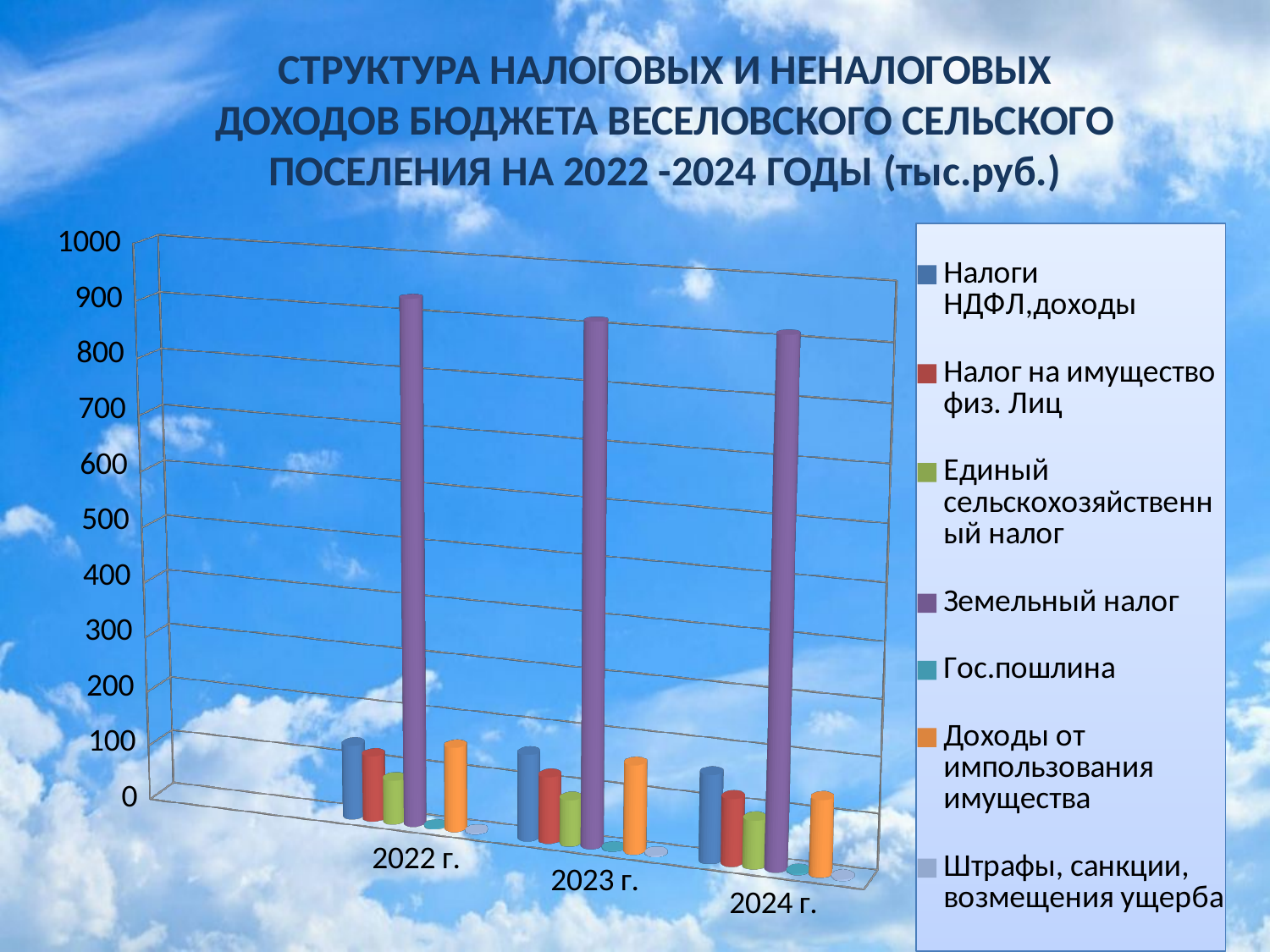
Which is larger: Земельный налог in 2022 or Земельный налог in 2024? Земельный налог in 2022 What unit of measurement is stated in the chart title? тыс.руб. Which series has the highest value in 2022? Земельный налог How many year categories are shown on the x axis of the chart? 3 Which colour represents Земельный налог in the legend? purple How many series does the chart legend list? 7 Does the value of Земельный налог rise or fall from 2022 to 2024? fall What kind of chart is shown on the slide? bar chart Which series has the highest value in 2024? Земельный налог Is the value of Земельный налог in 2022 greater or less than 800? greater Is the value of Земельный налог in 2024 greater or less than 500? greater